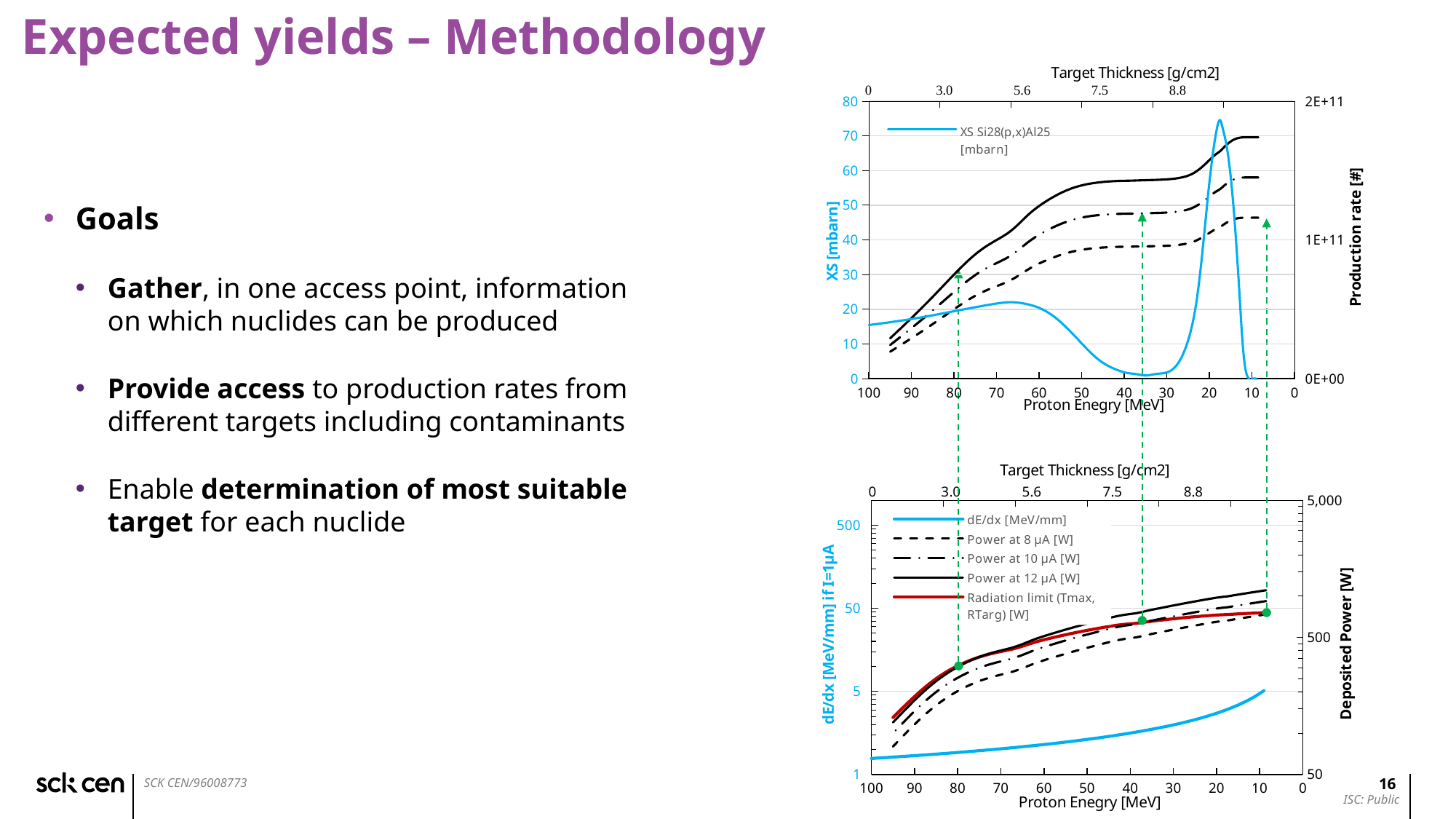
In the top chart, is the XS Si28(p,x)Al25 value at 100 MeV greater or less than 20? less In the bottom chart, is the dE/dx [MeV/mm] value at 100 MeV greater or less than 5? less What is the title of the top horizontal axis of the top chart? Target Thickness [g/cm2] How many series does the legend of the top chart list? 1 How many series does the legend of the bottom chart list? 5 In the bottom chart, does the dE/dx [MeV/mm] curve rise or fall moving from left to right along the x axis? rise In the top chart, is the XS Si28(p,x)Al25 value at 40 MeV greater or less than 10? less What kind of chart is the top chart on the slide? line chart What is the label of the right-hand vertical axis of the bottom chart? Deposited Power [W] In the bottom chart, at 100 MeV, which is higher: the dE/dx [MeV/mm] curve or the Power at 12 µA [W] curve? Power at 12 µA [W] In the bottom chart, at 10 MeV, which is higher: Power at 12 µA [W] or Power at 8 µA [W]? Power at 12 µA [W]